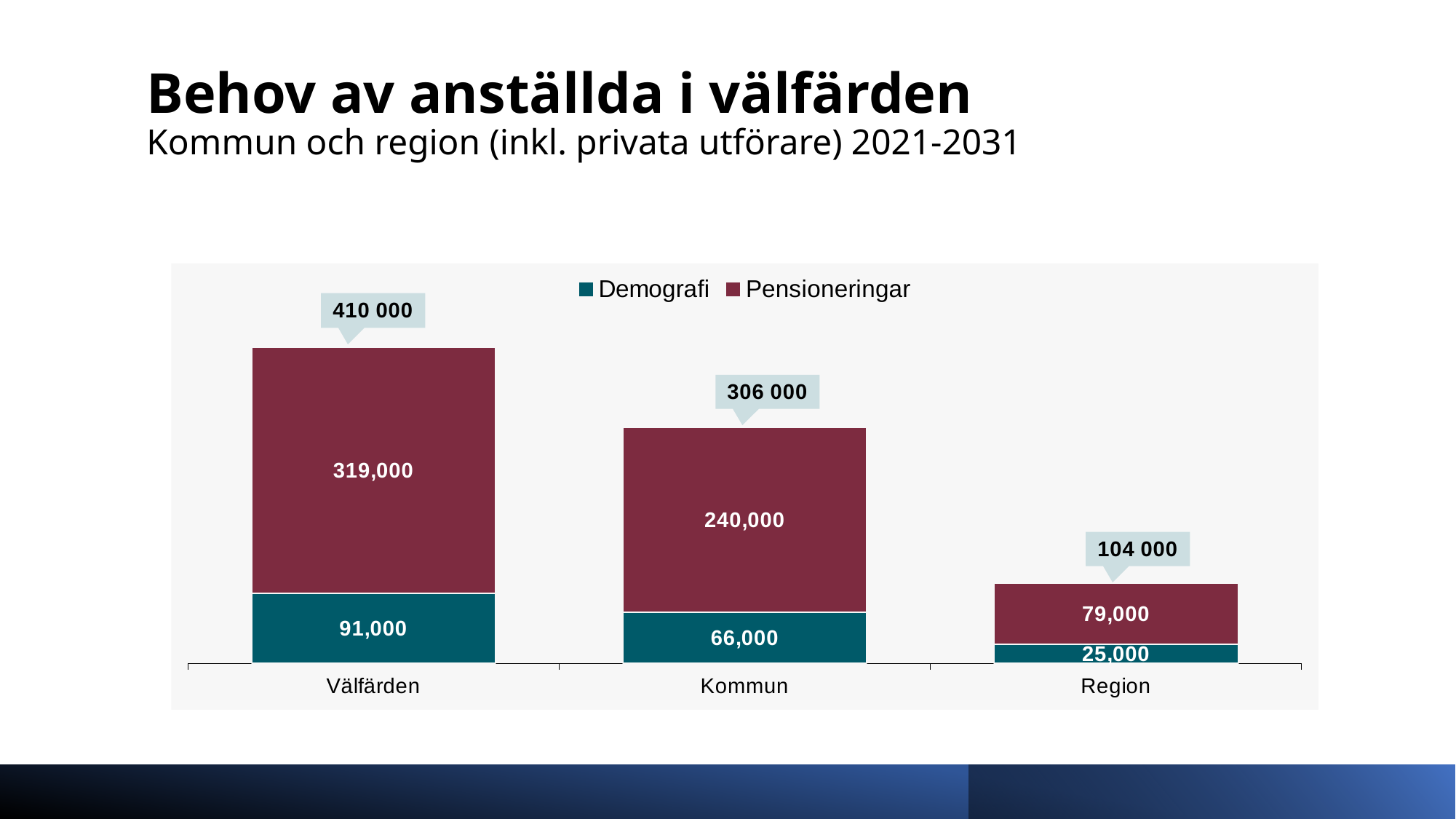
What is the total shown for the Kommun bar? 306 000 Which is larger, the Demografi value for Kommun or the Pensioneringar value for Region? Pensioneringar value for Region What is the Pensioneringar value for Region? 79,000 What is the difference between the Pensioneringar values for Välfärden and Kommun? 79,000 How many series does the legend list? 2 What is the Pensioneringar value for Kommun? 240,000 How many categories are shown on the x axis? 3 What is the Demografi value for Välfärden? 91,000 What is the Demografi value for Region? 25,000 Which category has the lowest total? Region What is the total shown for the Välfärden bar? 410 000 Which category has the highest Pensioneringar value? Välfärden